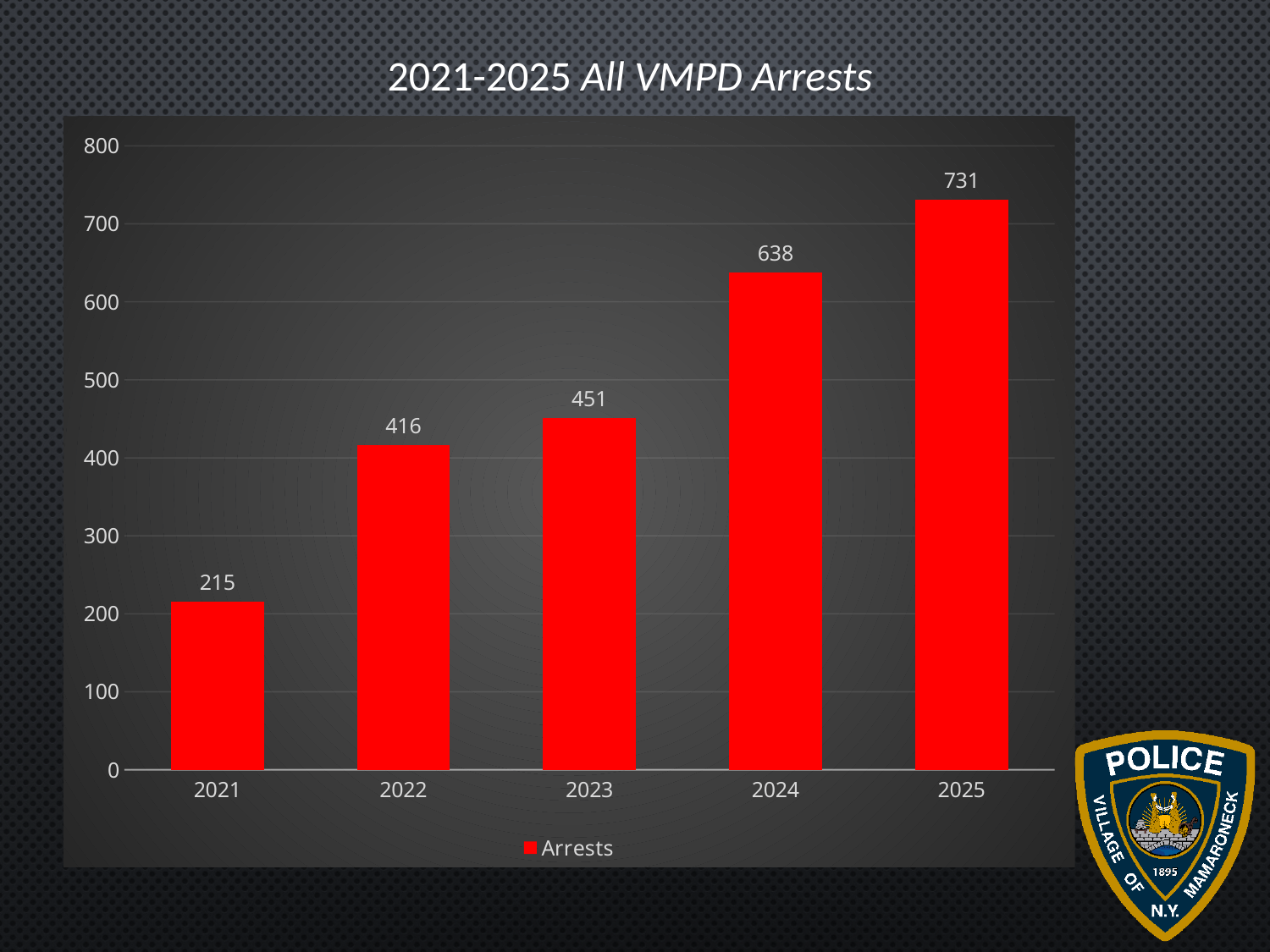
Do the arrest values rise or fall from 2021 to 2025? Rise Which year has the highest number of arrests? 2025 What is the difference in arrests between 2025 and 2021? 516 Which year had more arrests, 2022 or 2024? 2024 What kind of chart is shown on the slide? Bar chart Which year has the lowest number of arrests? 2021 Is the value for 2022 greater or less than 400? greater What is the number of arrests in 2025? 731 What is the number of arrests in 2021? 215 What is the difference in arrests between 2024 and 2023? 187 What is the number of arrests in 2023? 451 How many years are shown on the x axis? 5